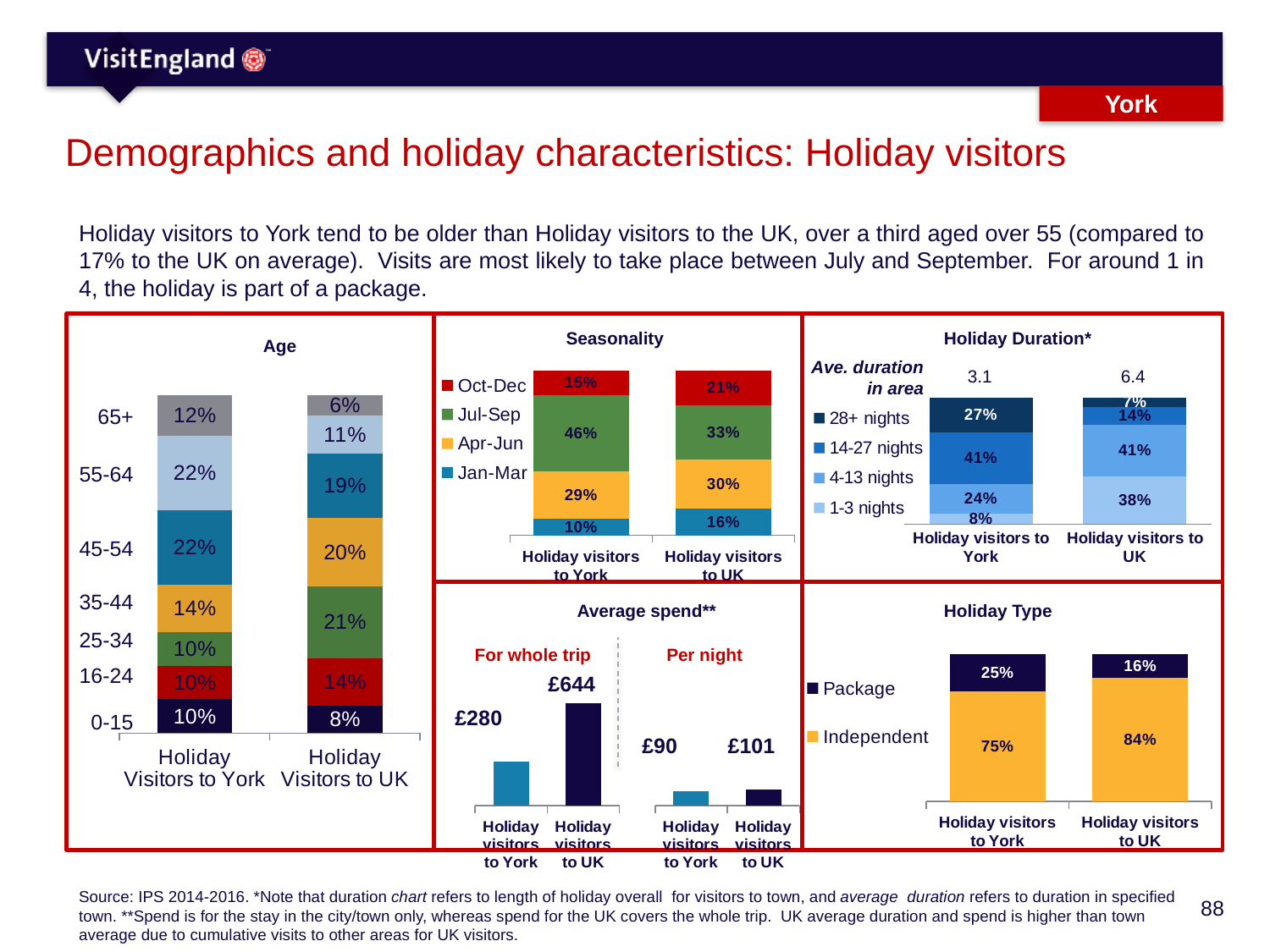
In the Holiday Duration chart, what percentage of Holiday visitors to UK stay 1-3 nights? 38% In the Holiday Type chart, which group has the larger Independent share, Holiday visitors to York or Holiday visitors to UK? Holiday visitors to UK In the Average spend chart, what is the difference between the per night spend for Holiday visitors to UK and Holiday visitors to York? £11 In the Age chart, what is the difference between the 25-34 share for Holiday Visitors to UK and Holiday Visitors to York? 11% In the Average spend chart, what is the average spend for the whole trip for Holiday visitors to UK? £644 How many series does the legend of the Seasonality chart list? 4 What type of chart is the Holiday Type chart? Stacked bar chart In the Seasonality chart, what percentage of Holiday visitors to York visit in Jul-Sep? 46% In the Holiday Type chart, what percentage of Holiday visitors to York are on a Package holiday? 25% In the Holiday Duration chart, what is the average duration in area for Holiday visitors to York? 3.1 In the Seasonality chart, which season has the lowest share for Holiday visitors to York? Jan-Mar In the Age chart, what percentage of Holiday Visitors to York are aged 65+? 12%